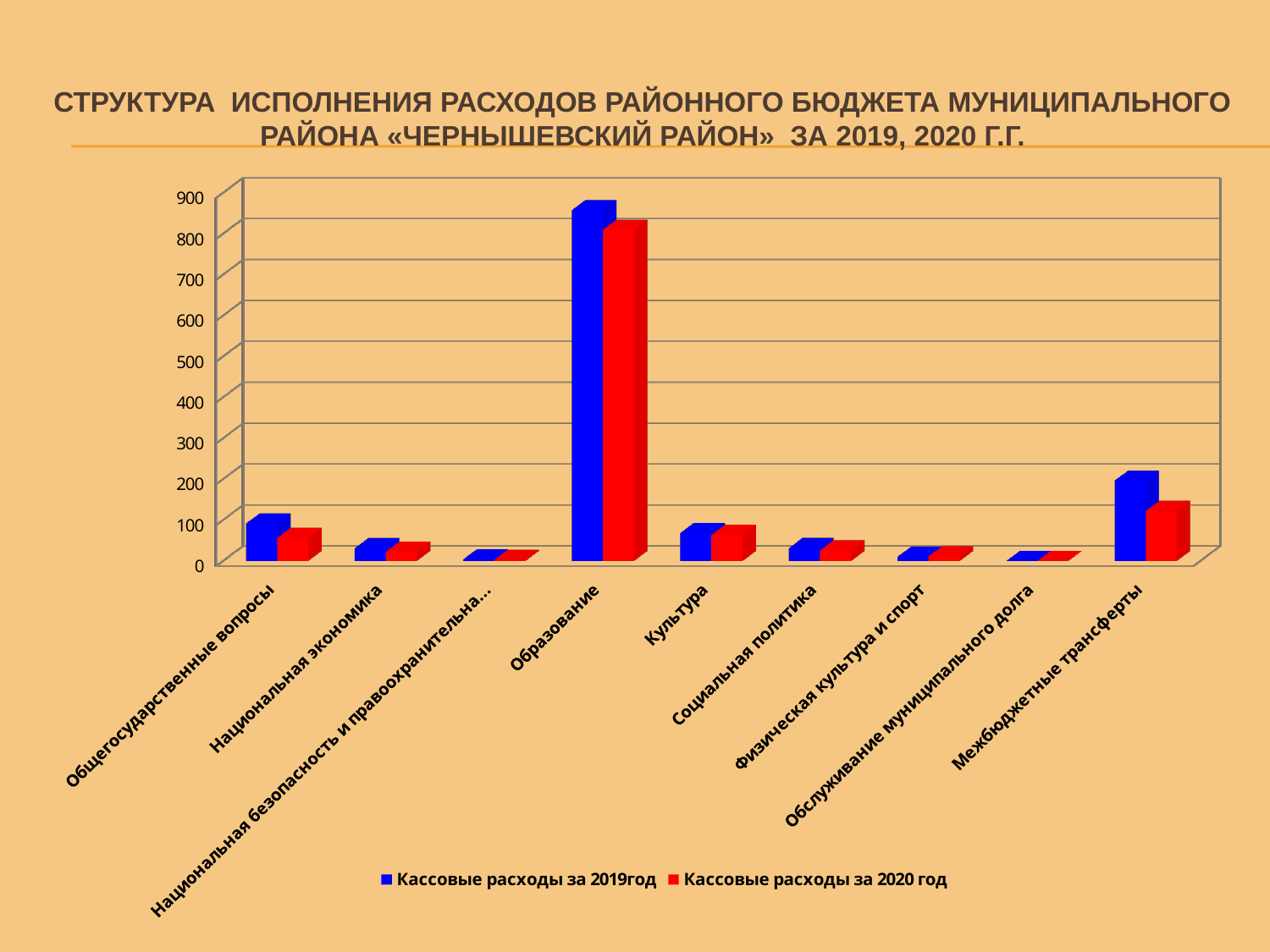
Is the value for Национальная экономика in Кассовые расходы за 2019год greater or less than 100? less Which category has the highest value for Кассовые расходы за 2019год? Образование Which category has the highest value for Кассовые расходы за 2020 год? Образование Is the value for Межбюджетные трансферты in Кассовые расходы за 2020 год greater or less than 100? greater For Образование, which series has the larger value: Кассовые расходы за 2019год or Кассовые расходы за 2020 год? Кассовые расходы за 2019год Is the value for Культура in Кассовые расходы за 2019год greater or less than 100? less How many series does the legend list? 2 Which colour represents Кассовые расходы за 2020 год in the legend? Red For Межбюджетные трансферты, which series has the larger value: Кассовые расходы за 2019год or Кассовые расходы за 2020 год? Кассовые расходы за 2019год How many expenditure categories are shown on the x axis? 9 What kind of chart is shown on the slide? Bar chart